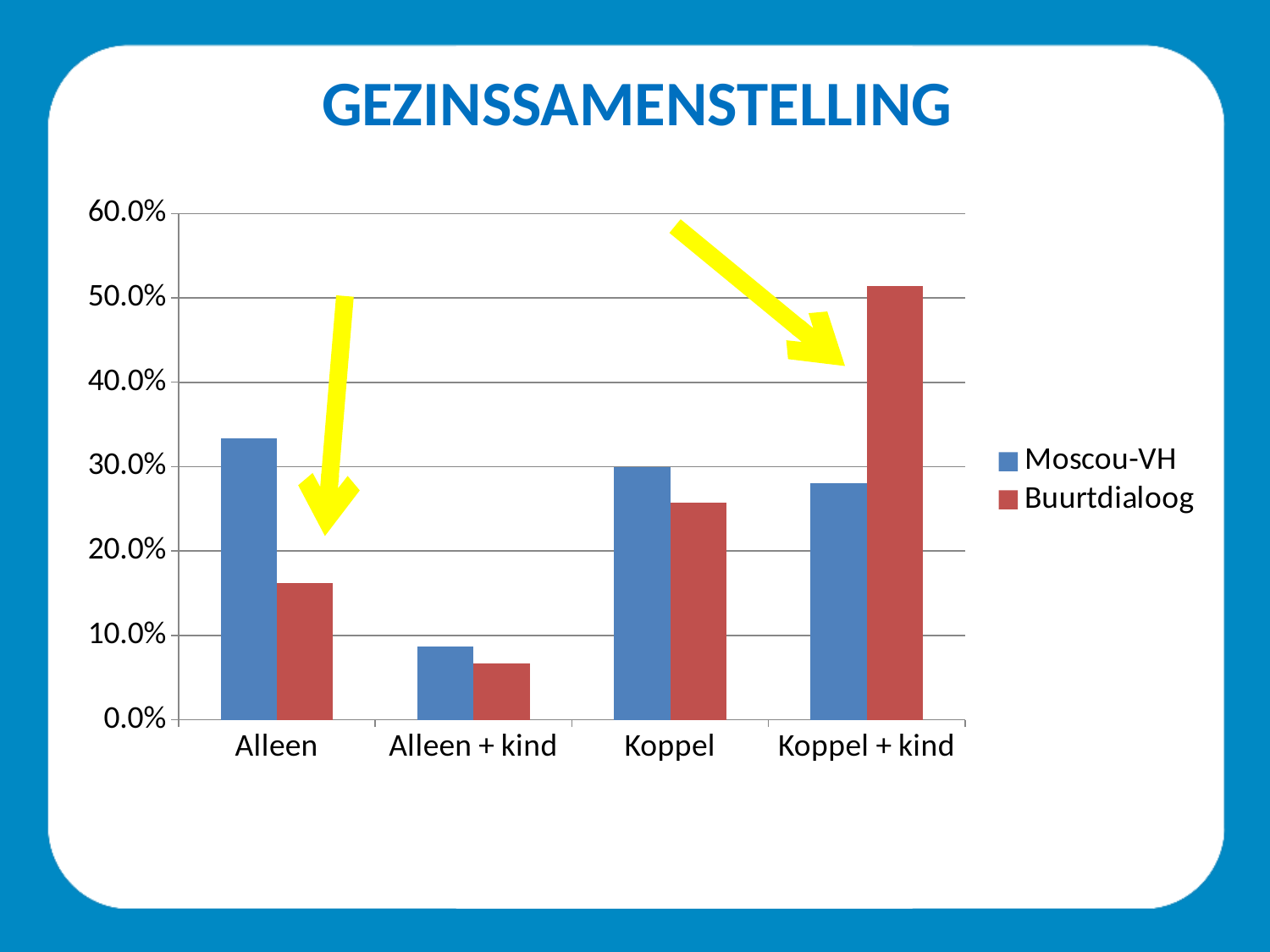
Is the Buurtdialoog value for Koppel greater or less than 30.0%? less Is the Moscou-VH value for Alleen greater or less than 30.0%? greater For which category is the Buurtdialoog value highest? Koppel + kind For which category is the Moscou-VH value lowest? Alleen + kind For the category Alleen, which series has the larger value, Moscou-VH or Buurtdialoog? Moscou-VH For the category Koppel + kind, which series has the larger value, Moscou-VH or Buurtdialoog? Buurtdialoog Which series is shown in red? Buurtdialoog For which category is the Moscou-VH value highest? Alleen What is the title of the chart? GEZINSSAMENSTELLING How many series does the legend list? 2 How many categories are shown on the x axis? 4 What kind of chart is shown on the slide? bar chart